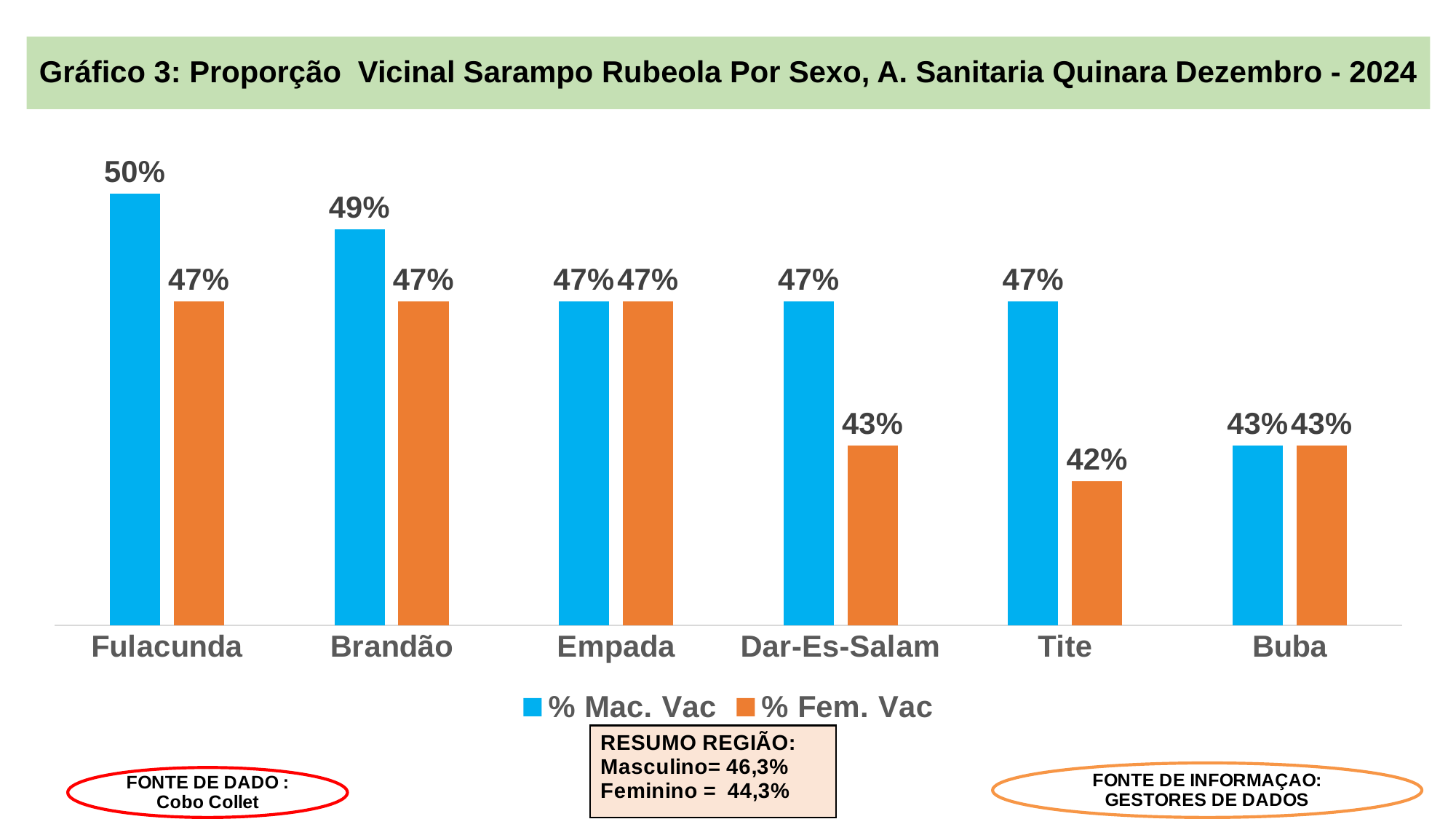
Which category has the highest % Mac. Vac value? Fulacunda What is the % Fem. Vac value for Tite? 42% Which is larger for Dar-Es-Salam, % Mac. Vac or % Fem. Vac? % Mac. Vac What kind of chart is shown on the slide? Bar chart How many categories are shown on the x axis? 6 How many series does the legend list? 2 Which category has the lowest % Fem. Vac value? Tite What is the difference between the % Mac. Vac values for Fulacunda and Buba? 7% What is the % Mac. Vac value for Brandão? 49% What is the difference between the % Mac. Vac and % Fem. Vac values for Tite? 5% What is the % Fem. Vac value for Dar-Es-Salam? 43% What is the % Mac. Vac value for Fulacunda? 50%